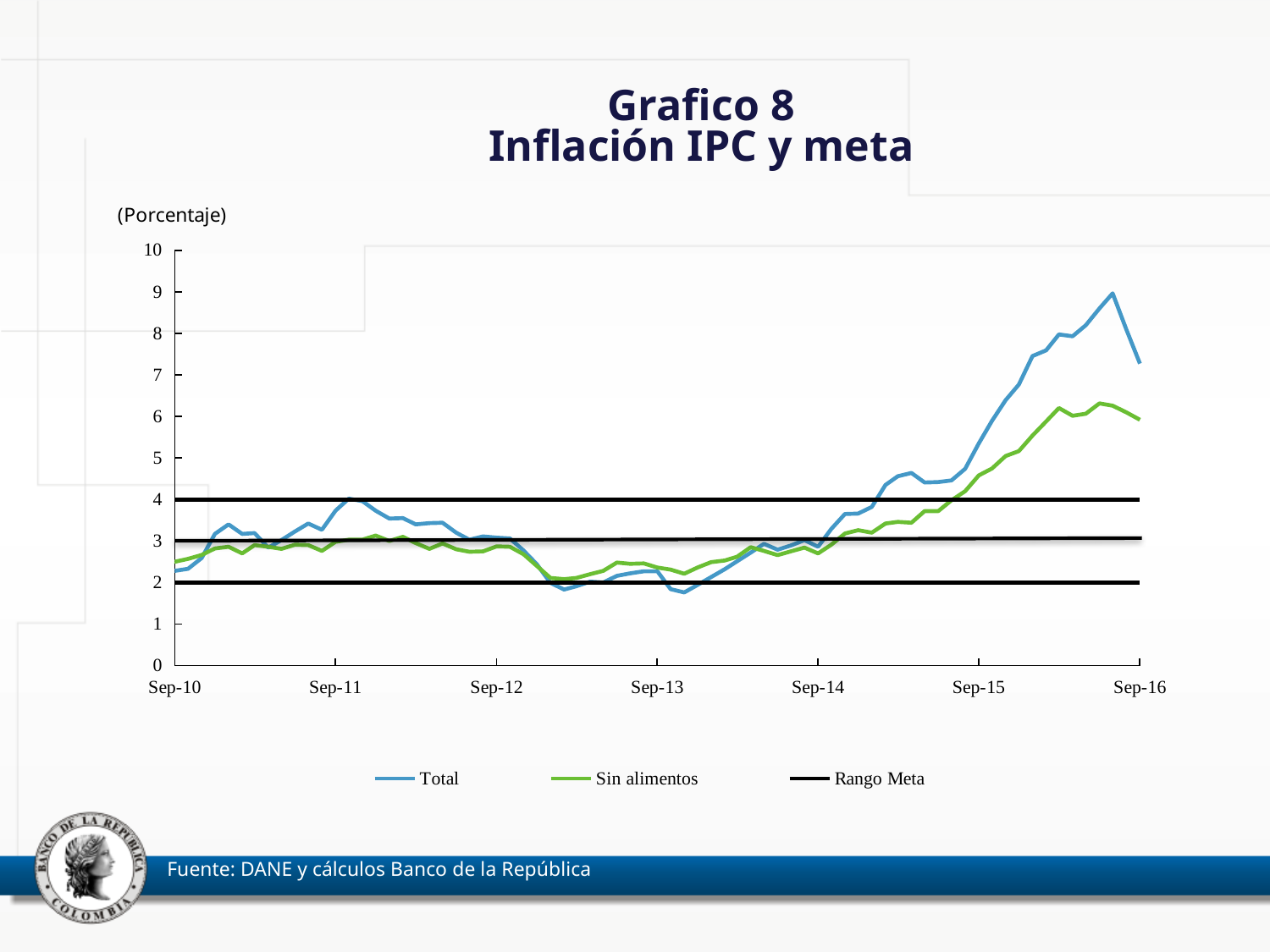
At what value is the lower Rango Meta line drawn? 2 At what value is the upper Rango Meta line drawn? 4 Is the value of the Total series at Sep-13 greater or less than 3? less Does the Total series rise or fall between Sep-14 and Sep-15? Rise In what unit are the values on the chart expressed, according to the label above the axis? Porcentaje Is the value of the Total series at Sep-16 greater or less than 6? greater What is the title of the chart? Inflación IPC y meta What kind of chart is shown on the slide? Line chart Which series reaches the highest value on the chart? Total At Sep-16, which series has the higher value, Total or Sin alimentos? Total How many series does the legend list? 3 Is the value of the Sin alimentos series at Sep-16 greater or less than 5? greater